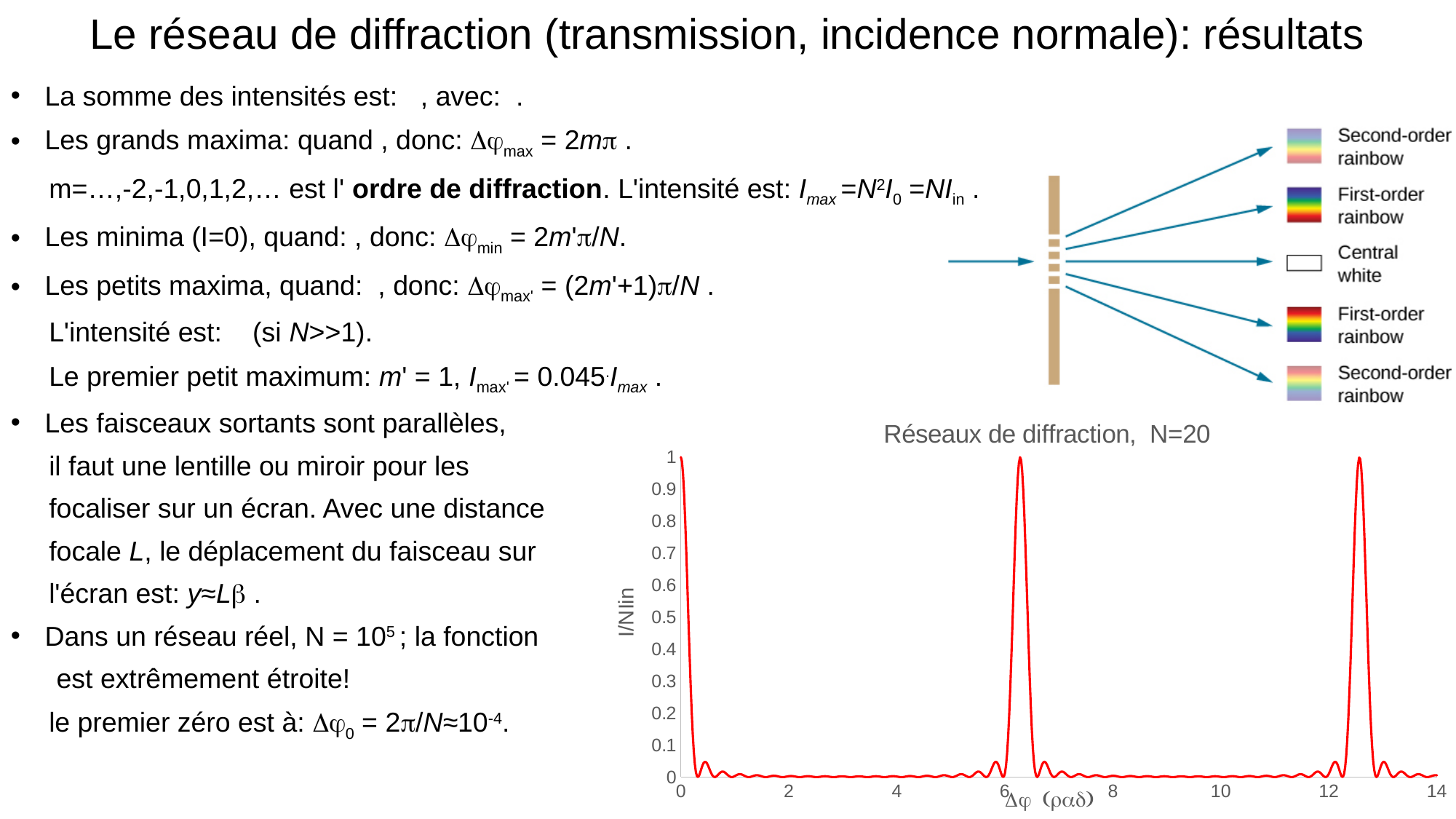
Is the value of the curve at Δφ = 2 greater or less than 0.1? less What is the value of the curve at Δφ = 0? 1 How many large peaks reaching 1 does the curve show? 3 What kind of chart is shown on the slide? line chart What is the highest value reached by the curve on the chart? 1 Is the value of the curve at Δφ = 10 greater or less than 0.2? less Which is larger: the value of the curve at Δφ = 0 or at Δφ = 8? Δφ = 0 Is the value of the curve at Δφ = 4 greater or less than 0.5? less What is the maximum value shown on the x axis of the chart? 14 What is the title of the chart? Réseaux de diffraction, N=20 What is the label of the y axis of the chart? I/NIin How many data series are plotted on the chart? 1